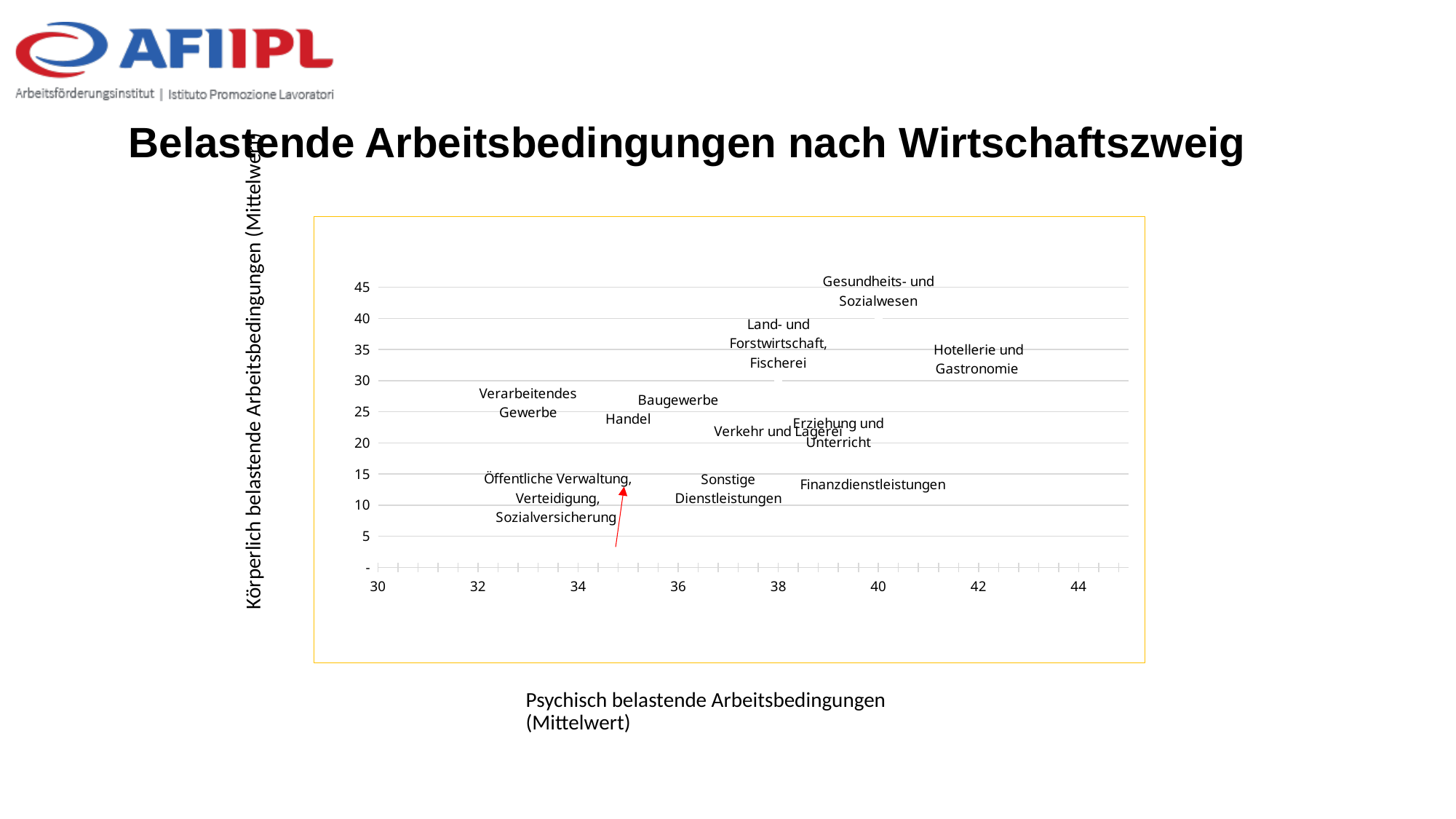
What is the title of the chart on the slide? Belastende Arbeitsbedingungen nach Wirtschaftszweig Is the horizontal-axis value for Hotellerie und Gastronomie greater or less than 40? greater What is the highest tick value shown on the vertical axis of the chart? 45 Is the vertical-axis value for Öffentliche Verwaltung, Verteidigung, Sozialversicherung greater or less than 20? less What is the label of the horizontal axis of the chart? Psychisch belastende Arbeitsbedingungen (Mittelwert) Is the vertical-axis value for Gesundheits- und Sozialwesen greater or less than 30? greater How many economic sectors (Wirtschaftszweige) are labelled in the chart? 11 Which sector has the highest value on the vertical axis (Körperlich belastende Arbeitsbedingungen)? Gesundheits- und Sozialwesen What kind of chart is shown on the slide? Scatter chart Which has the higher horizontal-axis value, Hotellerie und Gastronomie or Verarbeitendes Gewerbe? Hotellerie und Gastronomie Which has the higher vertical-axis value, Gesundheits- und Sozialwesen or Handel? Gesundheits- und Sozialwesen